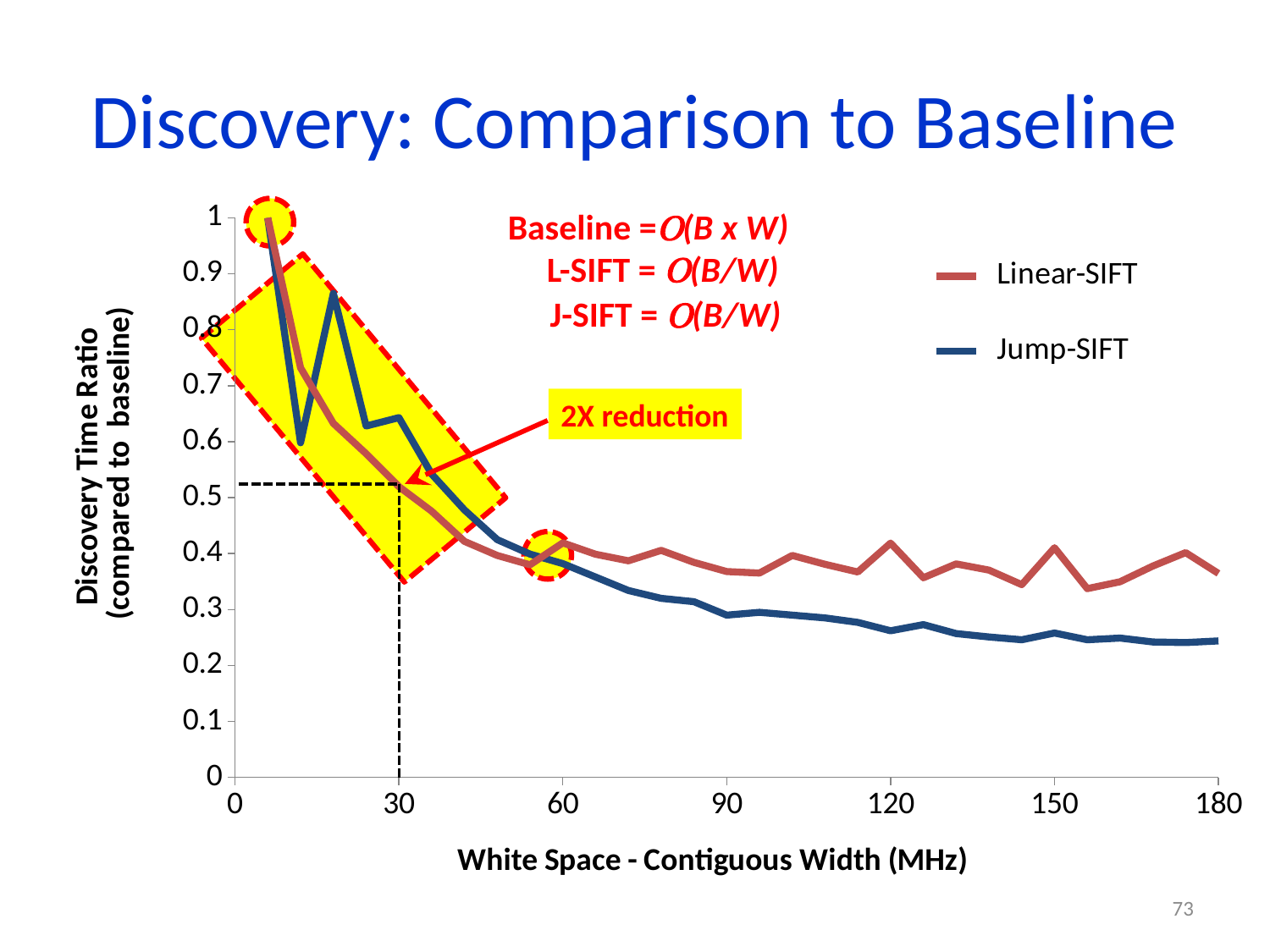
How many series does the legend list? 2 Is the Linear-SIFT value at 180 MHz greater or less than 0.3? greater At a contiguous width of 180 MHz, which series has the higher discovery time ratio, Linear-SIFT or Jump-SIFT? Linear-SIFT Is the Jump-SIFT value at 60 MHz greater or less than 0.5? less What kind of chart is shown on the slide? line chart What is the label of the x axis? White Space - Contiguous Width (MHz) Is the Jump-SIFT value at 180 MHz greater or less than 0.3? less Which series stays higher over the range from 90 MHz to 180 MHz? Linear-SIFT What are the two series named in the legend? Linear-SIFT and Jump-SIFT What is the largest value shown on the x axis? 180 Do the Jump-SIFT values generally rise or fall as the contiguous width increases? fall